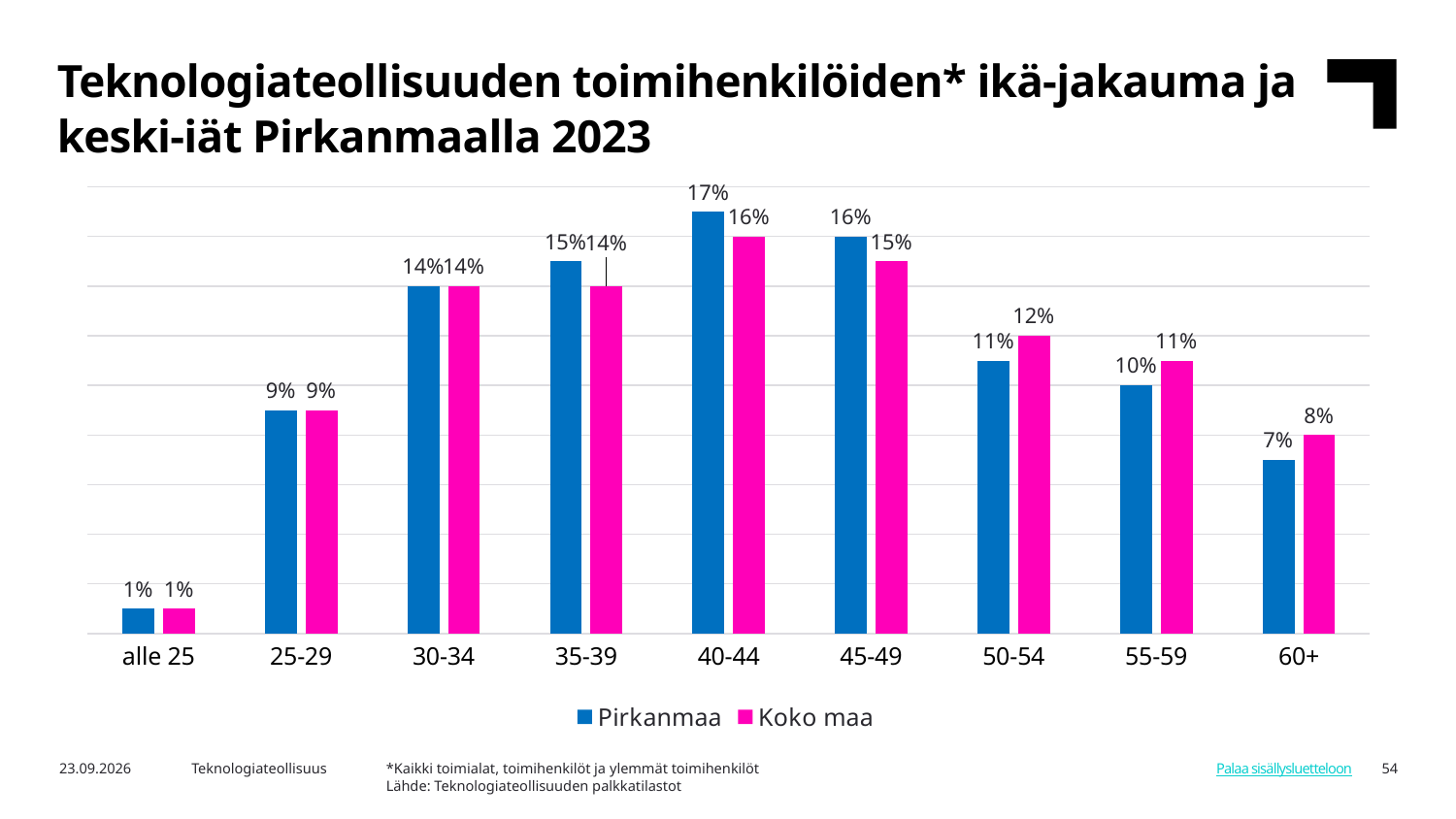
Which colour represents the Koko maa series? Pink What is the Pirkanmaa value for the 60+ age group? 7% Do the Koko maa values rise or fall from the 45-49 age group to the 60+ age group? Fall Which is larger for the 45-49 age group, the Pirkanmaa value or the Koko maa value? Pirkanmaa Which age group has the lowest Koko maa value? alle 25 How many age groups are shown on the x axis? 9 What kind of chart is shown on the slide? Bar chart What is the difference between the Pirkanmaa and Koko maa values for the 55-59 age group? 1% What is the Koko maa value for the 50-54 age group? 12% How many series does the legend list? 2 What is the Pirkanmaa value for the 40-44 age group? 17% Which age group has the highest Pirkanmaa value? 40-44